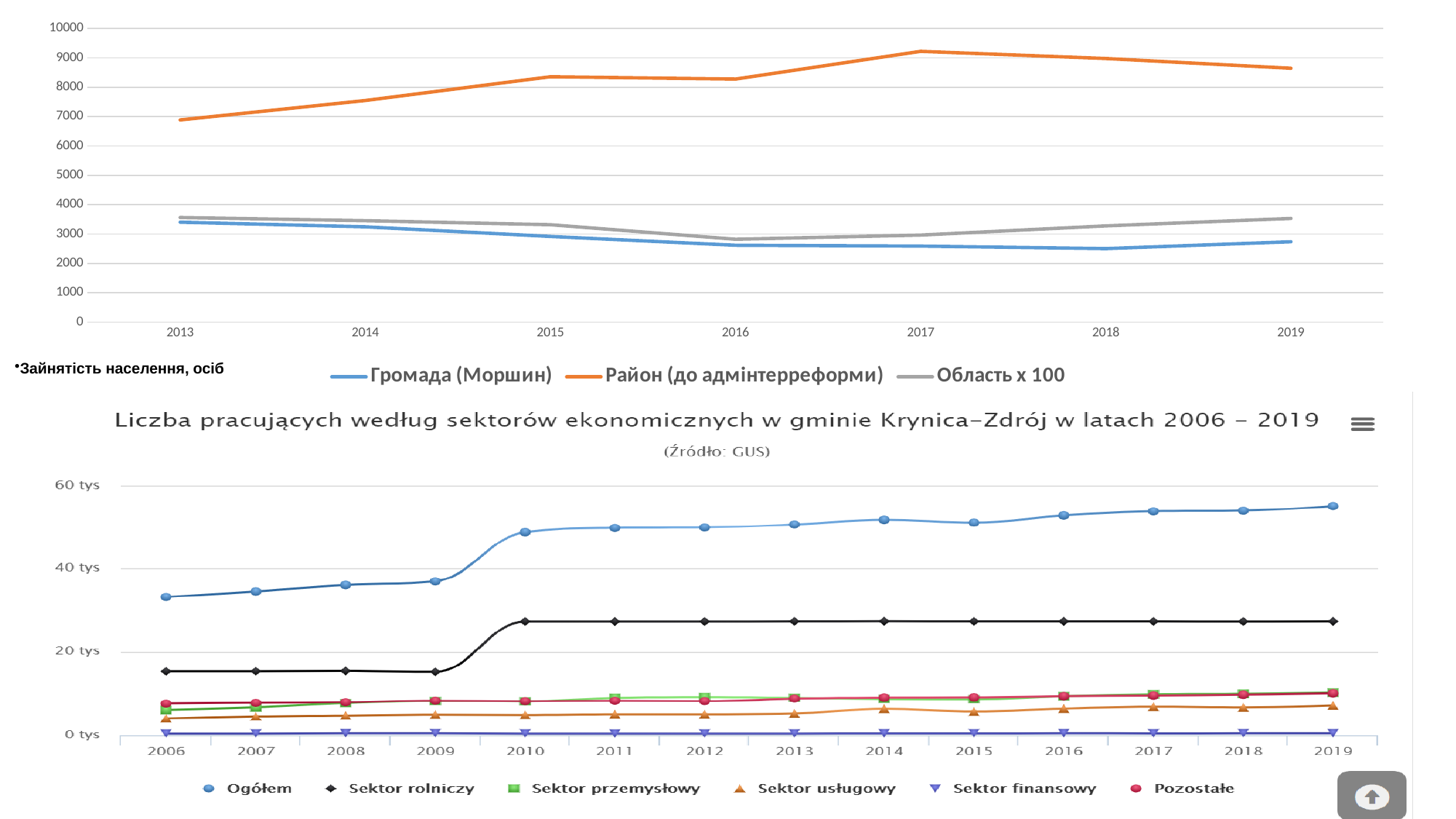
In the top chart, how many series does the legend list? 3 In the bottom chart, does the Ogółem line rise or fall from 2006 to 2019? rises In the bottom chart, how many series does the legend list? 6 In the top chart, which series has the highest values across all years? Район (до адмінтерреформи) In the bottom chart, is the value for Sektor rolniczy in 2010 greater or less than 20 tys? greater In the top chart, is the value for Область x 100 in 2016 greater or less than 3000? less In the top chart, how many years are shown on the x axis? 7 In the top chart, is the value for Громада (Моршин) in 2013 greater or less than 3000? greater What kind of chart is the bottom chart titled 'Liczba pracujących według sektorów ekonomicznych w gminie Krynica-Zdrój w latach 2006 – 2019'? line chart In the bottom chart, which series has the lowest values across all years? Sektor finansowy In the top chart, in which year does the Район (до адмінтерреформи) line reach its highest value? 2017